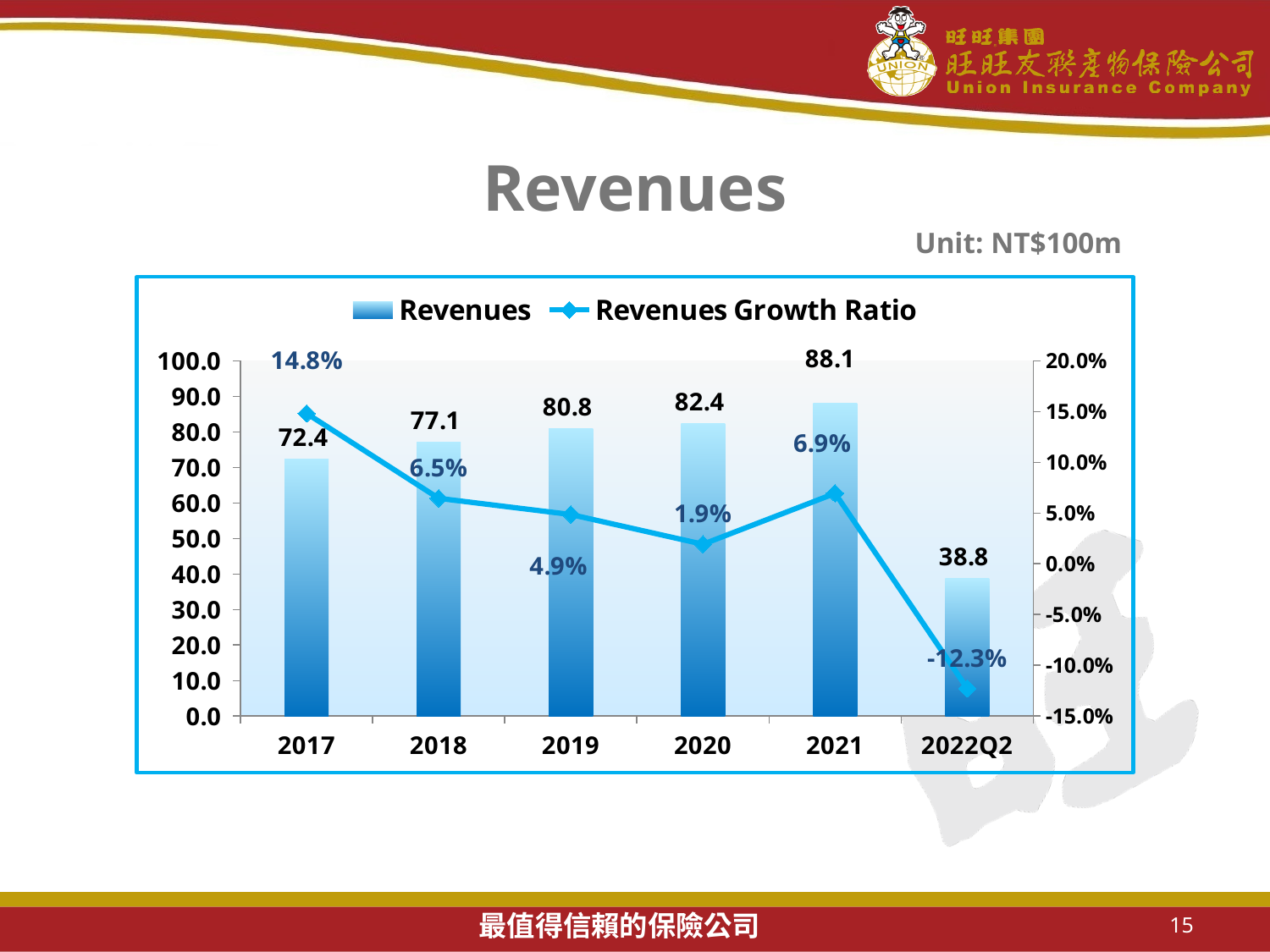
What is the Revenues value for 2019? 80.8 Which period has the lowest Revenues Growth Ratio? 2022Q2 How many periods are shown on the x axis? 6 Which is larger, the Revenues Growth Ratio for 2019 or for 2021? 2021 What is the Revenues Growth Ratio for 2022Q2? -12.3% What unit is stated for the chart? NT$100m How many series does the legend list? 2 What is the Revenues Growth Ratio for 2018? 6.5% What is the difference in Revenues between 2021 and 2020? 5.7 Do the Revenues values rise or fall from 2017 to 2021? rise Which period has the highest Revenues? 2021 Is the Revenues value for 2022Q2 greater or less than 40.0? less